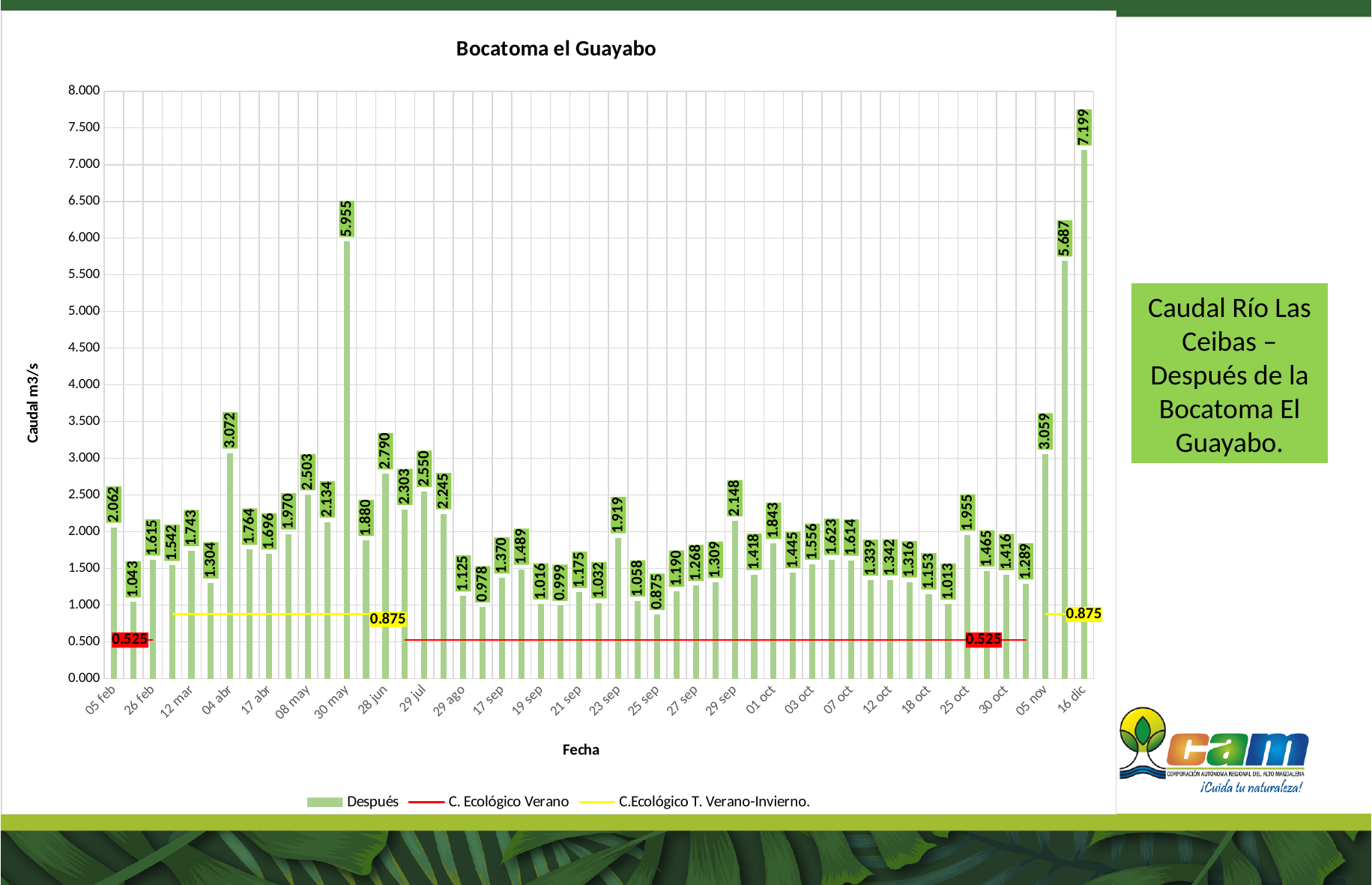
Which is larger, the Después value for 30 may or for 16 dic? 16 dic What value is labelled on the red C. Ecológico Verano line? 0.525 Is the Después value for 28 jun greater or less than 2.500? greater What is the value of the Después bar for 05 feb? 2.062 Which date has the highest Después value? 16 dic What is the value of the Después bar for 05 nov? 3.059 What is the difference between the bars for 04 abr (3.072) and 05 nov (3.059)? 0.013 What is the difference between the highest bar (7.199) and the bar for 30 may (5.955)? 1.244 How many series does the legend list? 3 What is the value of the Después bar for 30 may? 5.955 What kind of chart is shown? Combination bar and line chart Which date has the lowest Después value? 25 sep